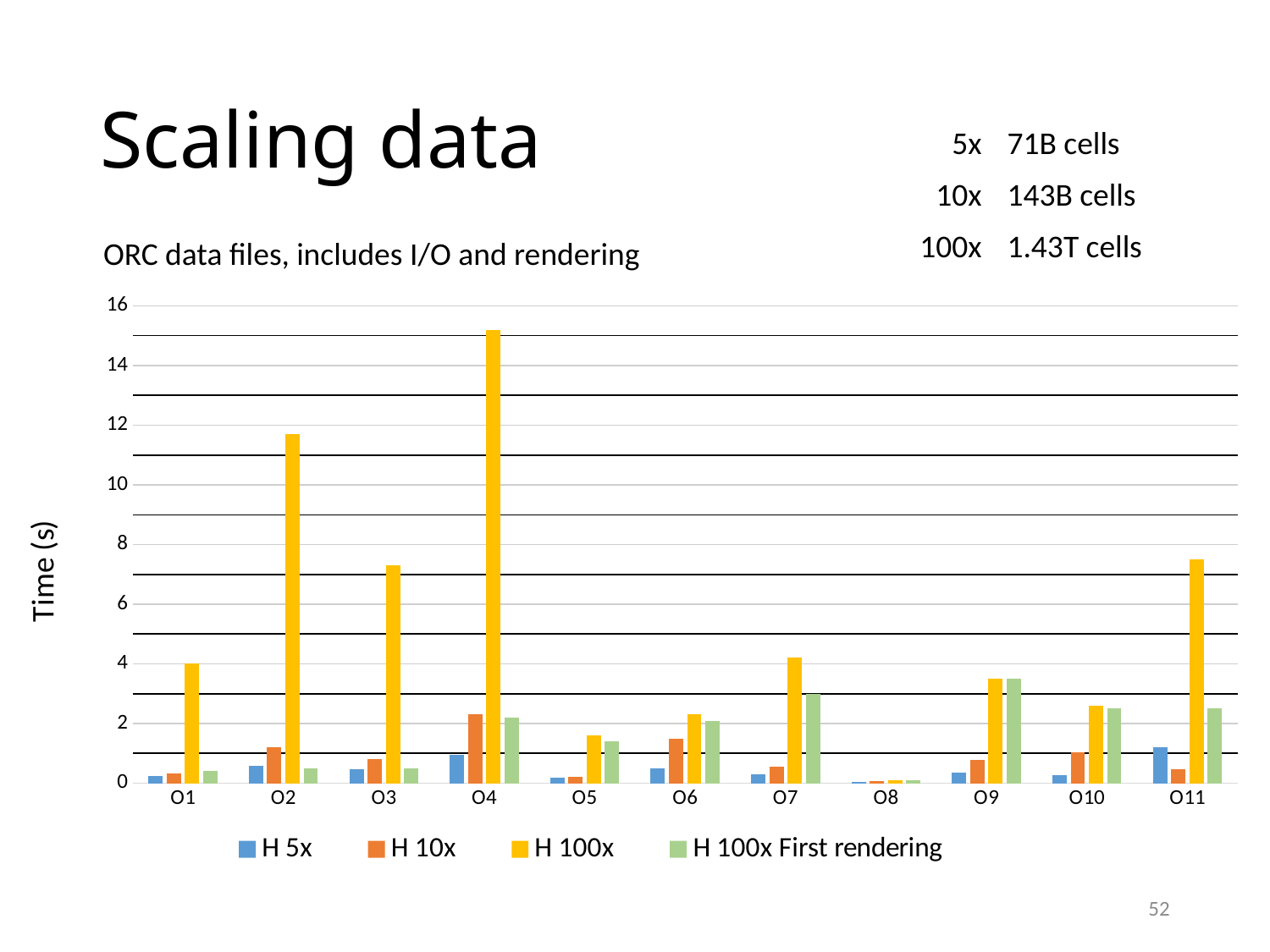
What kind of chart is shown on the slide? bar chart Which category has the lowest H 100x value? O8 How many categories are shown on the x axis of the chart? 11 Which is larger, the H 100x value for O7 or for O9? O7 How many series does the chart's legend list? 4 Which category has the highest H 100x value? O4 Is the H 100x value for O4 greater or less than 14? greater Is the H 100x value for O2 greater or less than 10? greater Which is larger, the H 100x value for O2 or for O3? O2 What is the label on the chart's vertical axis? Time (s) Is the H 100x value for O3 greater or less than 6? greater